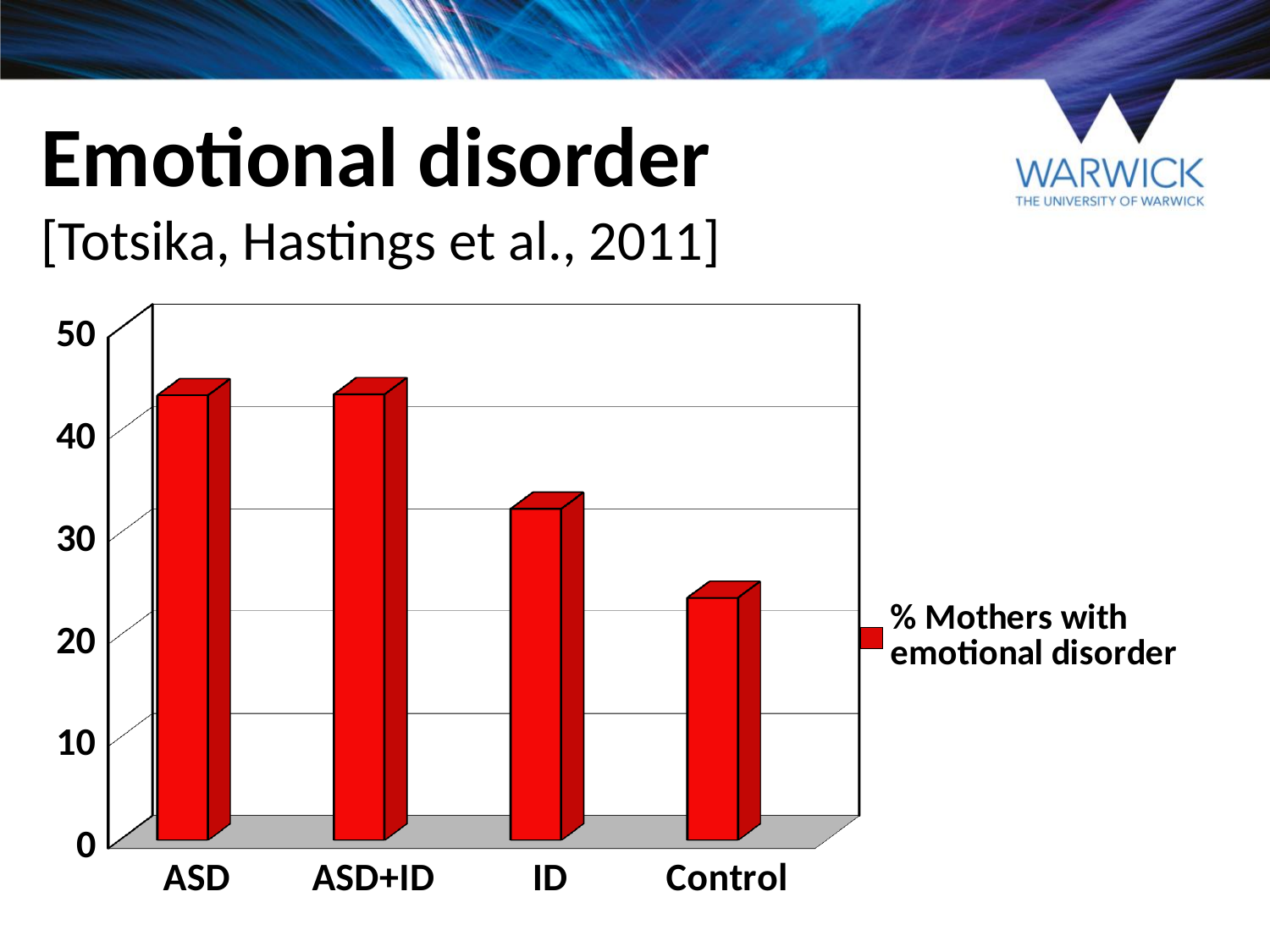
Is the value for Control greater or less than 20? greater Is the value for ID greater or less than 30? greater What kind of chart is shown on the slide? bar chart What is the legend entry for the series plotted in the chart? % Mothers with emotional disorder Is the value for ID greater or less than 40? less How many series does the chart legend list? 1 Which category has the lowest value in the chart? Control Which is larger, the value for ASD+ID or the value for ID? ASD+ID How many categories are shown on the x axis of the chart? 4 Which is larger, the value for ID or the value for Control? ID